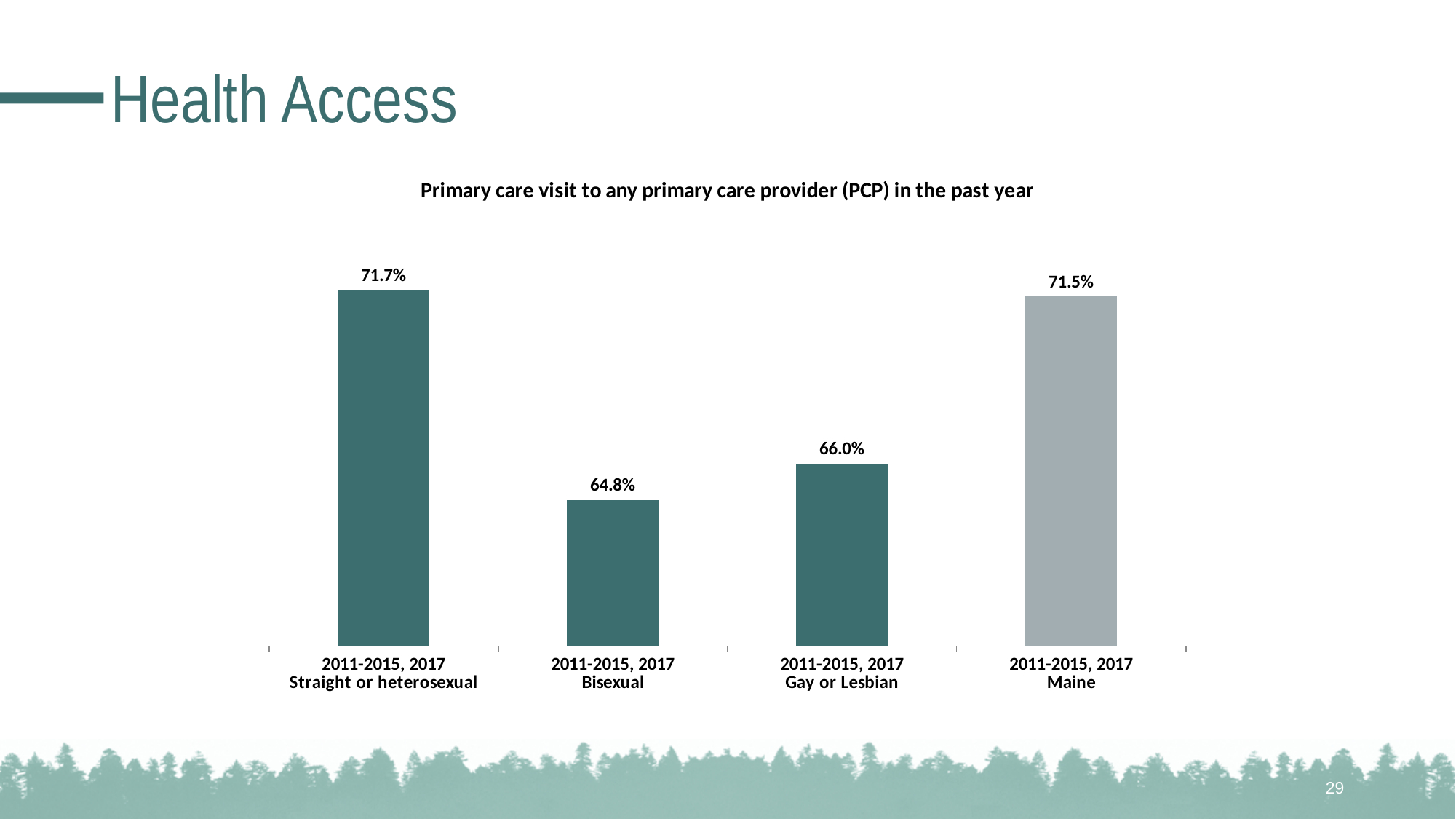
What kind of chart is shown on the slide? Bar chart What is the value for Bisexual in the chart? 64.8% Which category has the lowest value in the chart? Bisexual What is the difference between the values for Straight or heterosexual and Bisexual? 6.9 percentage points What is the difference between the values for Maine and Gay or Lesbian? 5.5 percentage points Which is larger, the value for Straight or heterosexual or the value for Gay or Lesbian? Straight or heterosexual What is the value for Maine in the chart? 71.5% Which is larger, the value for Gay or Lesbian or the value for Bisexual? Gay or Lesbian What is the title of the chart? Primary care visit to any primary care provider (PCP) in the past year What is the value for Gay or Lesbian in the chart? 66.0% What is the value for Straight or heterosexual in the chart? 71.7% How many bars are shown in the chart? 4